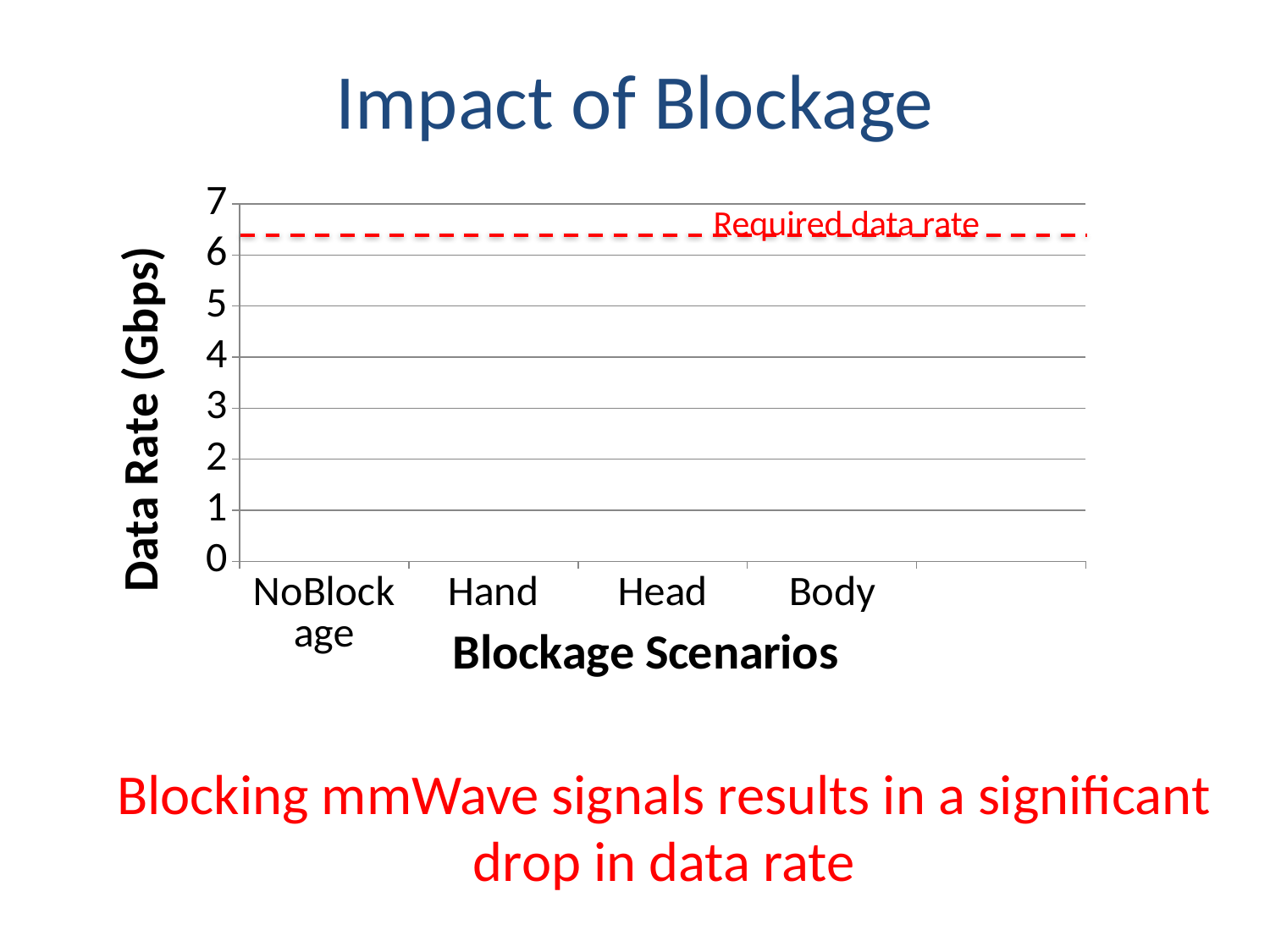
What is the title of the y axis of the chart? Data Rate (Gbps) How many blockage scenario categories are shown on the x axis of the chart? 4 Is the dashed 'Required data rate' line greater or less than 6 Gbps? greater Is the dashed 'Required data rate' line greater or less than 7 Gbps? less What is the title of the x axis of the chart? Blockage Scenarios